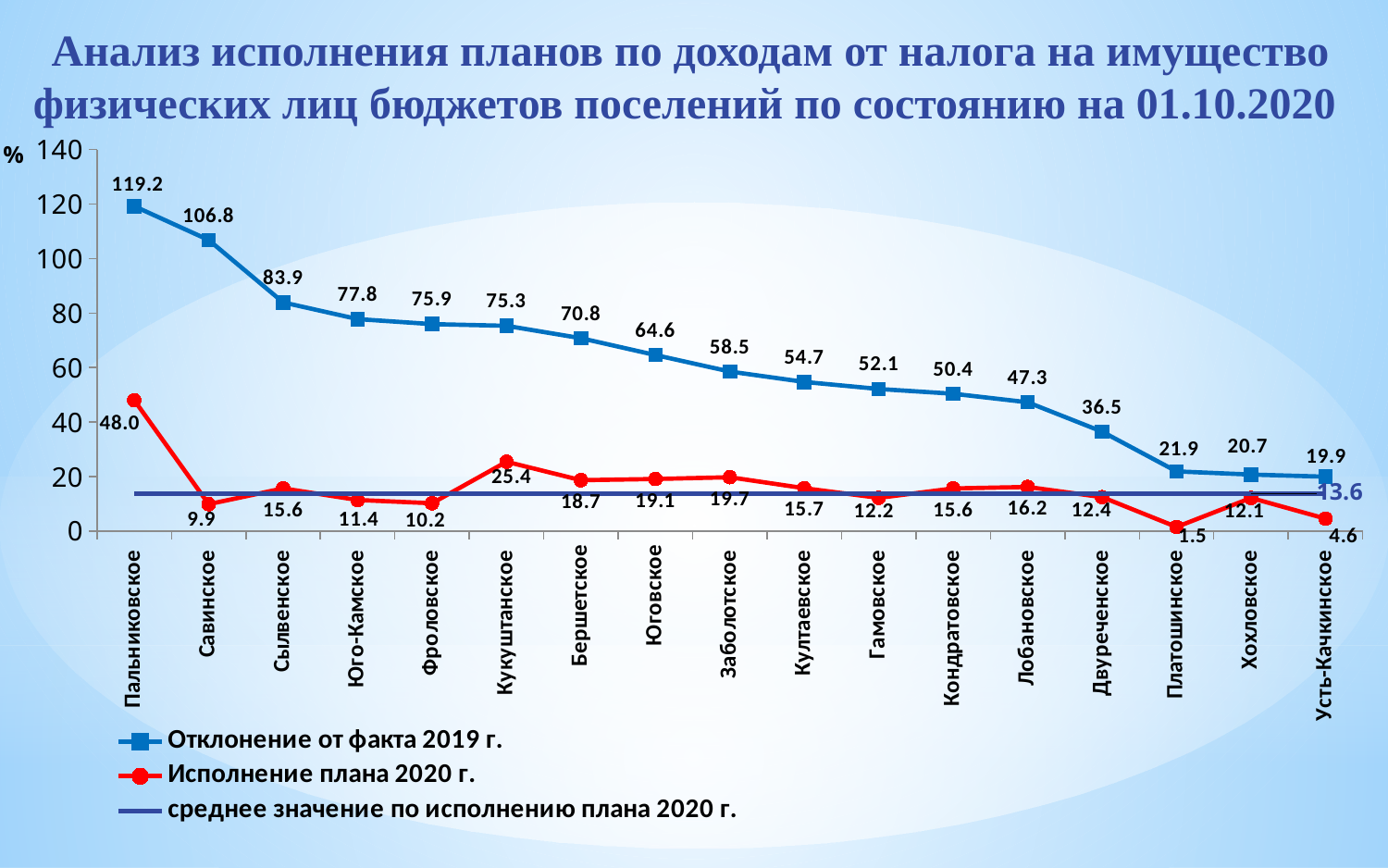
How many entries does the legend list? 3 What value does the 'среднее значение по исполнению плана 2020 г.' line show? 13.6 What is the difference between the 'Отклонение от факта 2019 г.' values for Пальниковское and Савинское? 12.4 Does the 'Отклонение от факта 2019 г.' series rise or fall from left to right along the x axis? Fall What kind of chart is shown on the slide? Line chart What is the value of the 'Отклонение от факта 2019 г.' series for Пальниковское? 119.2 Which category has the highest value in the 'Исполнение плана 2020 г.' series? Пальниковское Which category has the lowest value in the 'Исполнение плана 2020 г.' series? Платошинское Which is larger: the 'Исполнение плана 2020 г.' value for Бершетское or for Гамовское? Бершетское What is the value of the 'Исполнение плана 2020 г.' series for Кукуштанское? 25.4 How many categories are shown on the x axis? 17 Which category has the lowest value in the 'Отклонение от факта 2019 г.' series? Усть-Качкинское